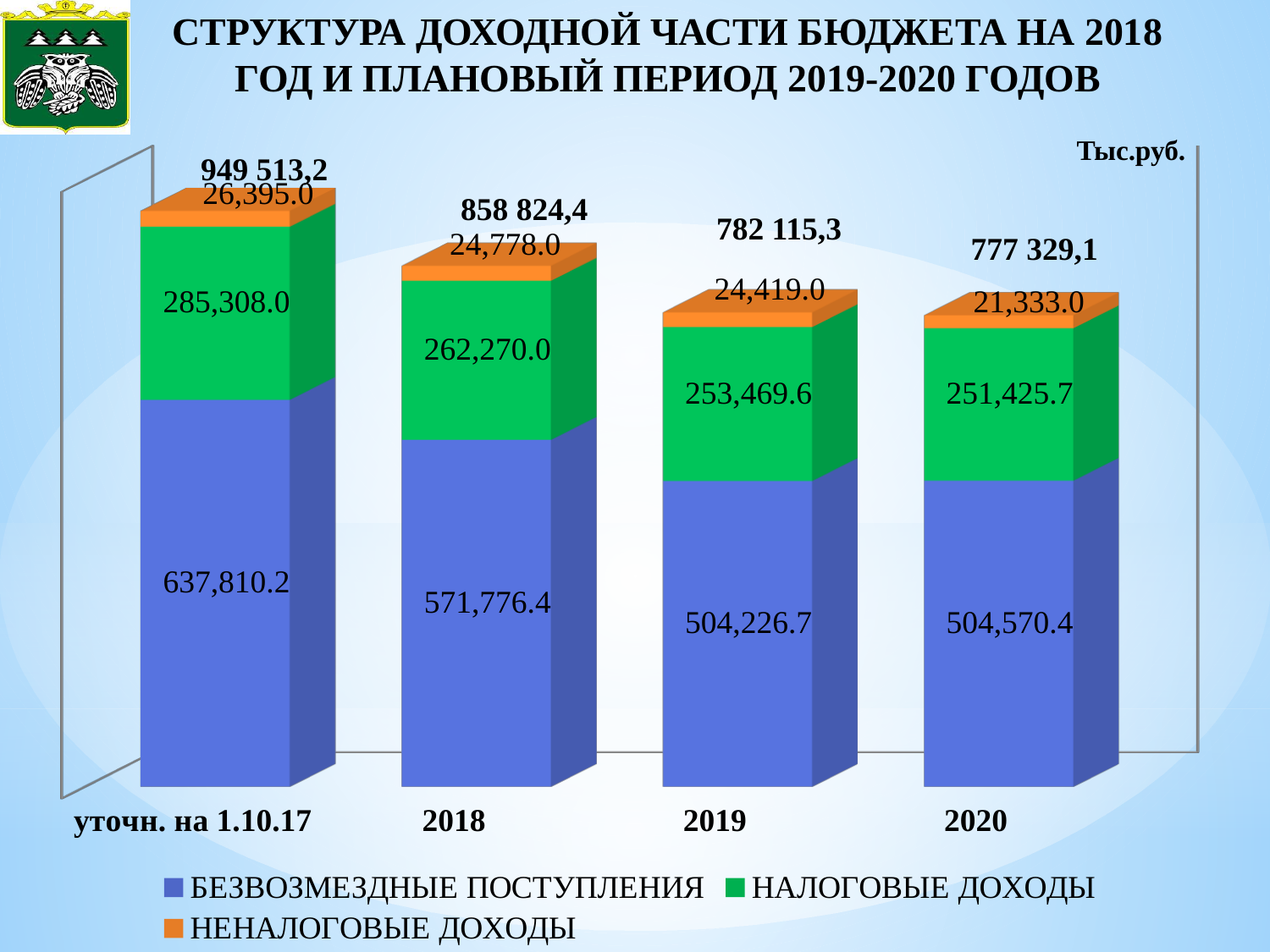
What kind of chart is shown on the slide? Stacked bar chart What is the value of НЕНАЛОГОВЫЕ ДОХОДЫ for 2020? 21,333.0 What is the value of НАЛОГОВЫЕ ДОХОДЫ for 2019? 253,469.6 What is the difference between НАЛОГОВЫЕ ДОХОДЫ for уточн. на 1.10.17 and for 2018? 23,038.0 What is the total printed above the bar for 2018? 858 824,4 What is the value of БЕЗВОЗМЕЗДНЫЕ ПОСТУПЛЕНИЯ for 2018? 571,776.4 Which category has the highest total? уточн. на 1.10.17 Do the bar totals rise or fall from уточн. на 1.10.17 to 2020? Fall Which category has the lowest value for НЕНАЛОГОВЫЕ ДОХОДЫ? 2020 How many series does the legend list? 3 Which is larger: БЕЗВОЗМЕЗДНЫЕ ПОСТУПЛЕНИЯ for 2018 or for 2019? 2018 How many categories are shown along the x axis? 4